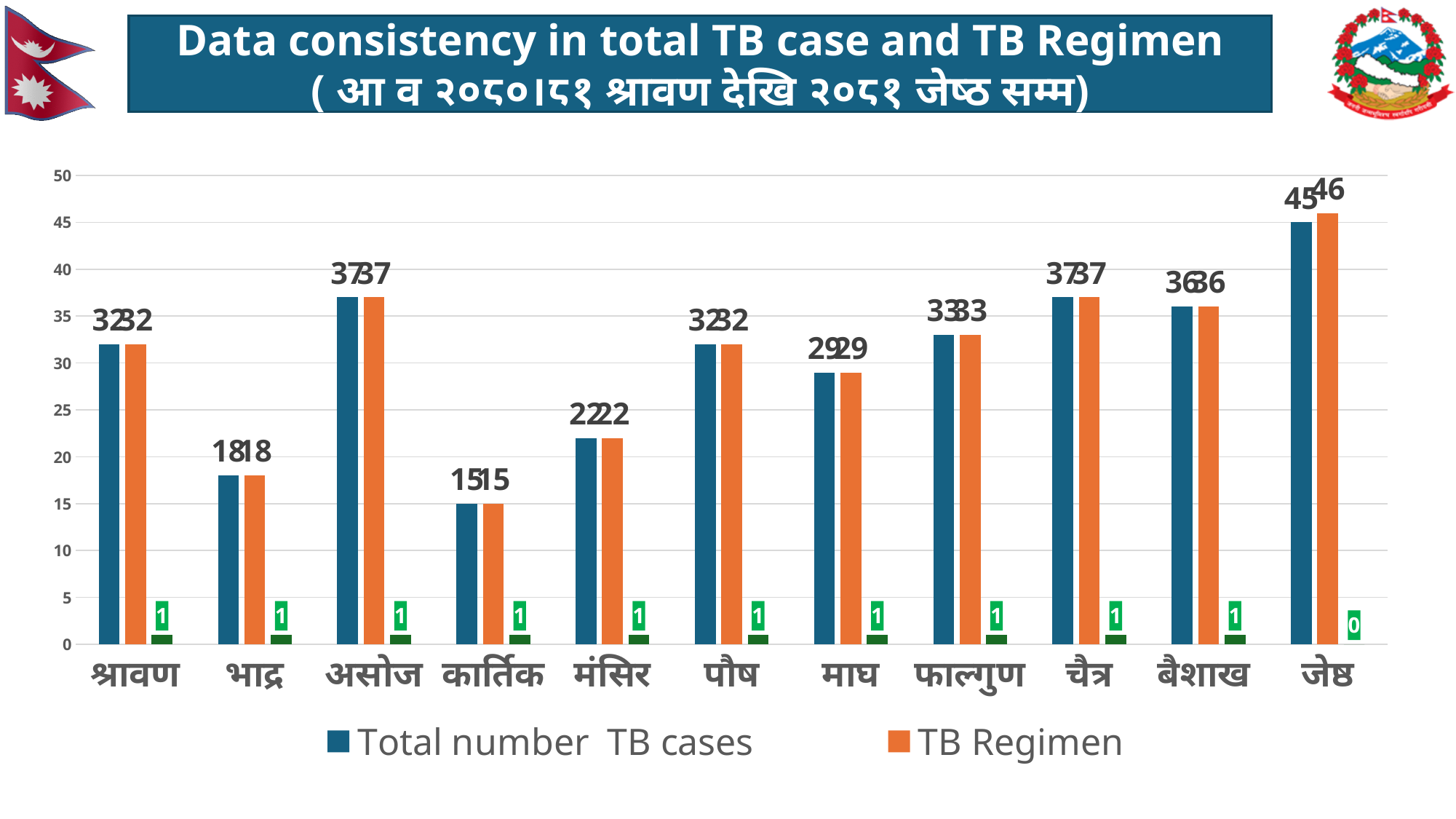
What is the difference between the TB Regimen value and the Total number TB cases value for जेष्ठ? 1 What is the Total number TB cases value for कार्तिक? 15 Which is larger, the Total number TB cases for असोज or for भाद्र? असोज What is the Total number TB cases value for बैशाख? 36 What is the difference between the Total number TB cases for चैत्र and for माघ? 8 What is the title of the chart on the slide? Data consistency in total TB case and TB Regimen Which month has the lowest TB Regimen value? कार्तिक What kind of chart is shown on the slide? bar chart How many months (categories) are shown on the x axis? 11 How many series does the legend list? 2 What is the TB Regimen value for जेष्ठ? 46 Which month has the highest Total number TB cases? जेष्ठ